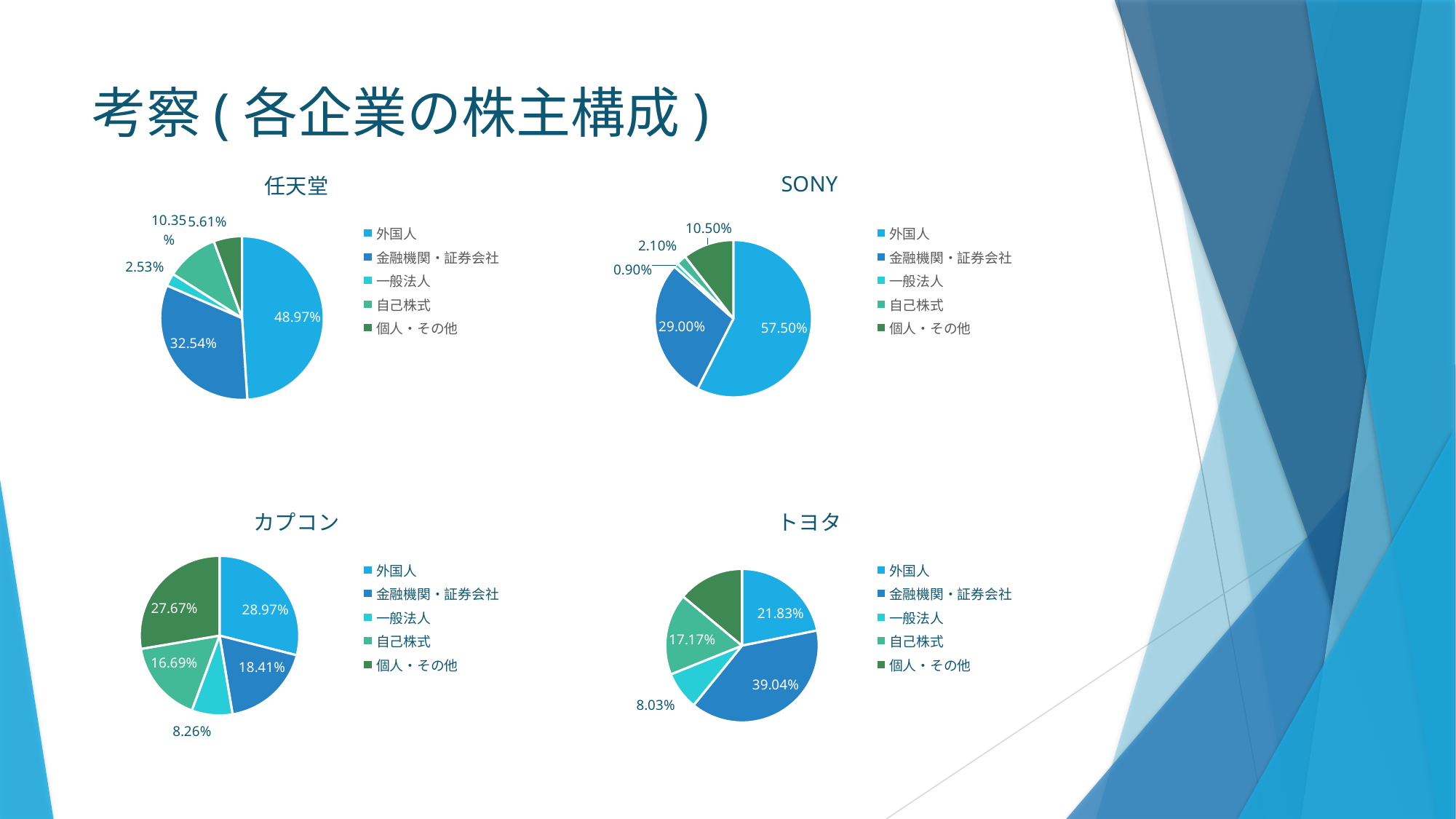
In the カプコン chart, which is larger, the 自己株式 share or the 金融機関・証券会社 share? 金融機関・証券会社 How many series does the legend of the SONY chart list? 5 In the SONY chart, what share is labelled for 一般法人? 0.90% In the トヨタ chart, which category has the largest slice? 金融機関・証券会社 What kind of chart is the カプコン chart? Pie chart In the トヨタ chart, what share is labelled for 金融機関・証券会社? 39.04% In the SONY chart, which category has the smallest slice? 一般法人 In the カプコン chart, what share is labelled for 個人・その他? 27.67% In the SONY chart, what share is labelled for 外国人? 57.50% In the 任天堂 chart, what share is labelled for 金融機関・証券会社? 32.54% In the 任天堂 chart, what share is labelled for 外国人? 48.97% In the 任天堂 chart, what is the difference between the 外国人 share and the 金融機関・証券会社 share? 16.43%